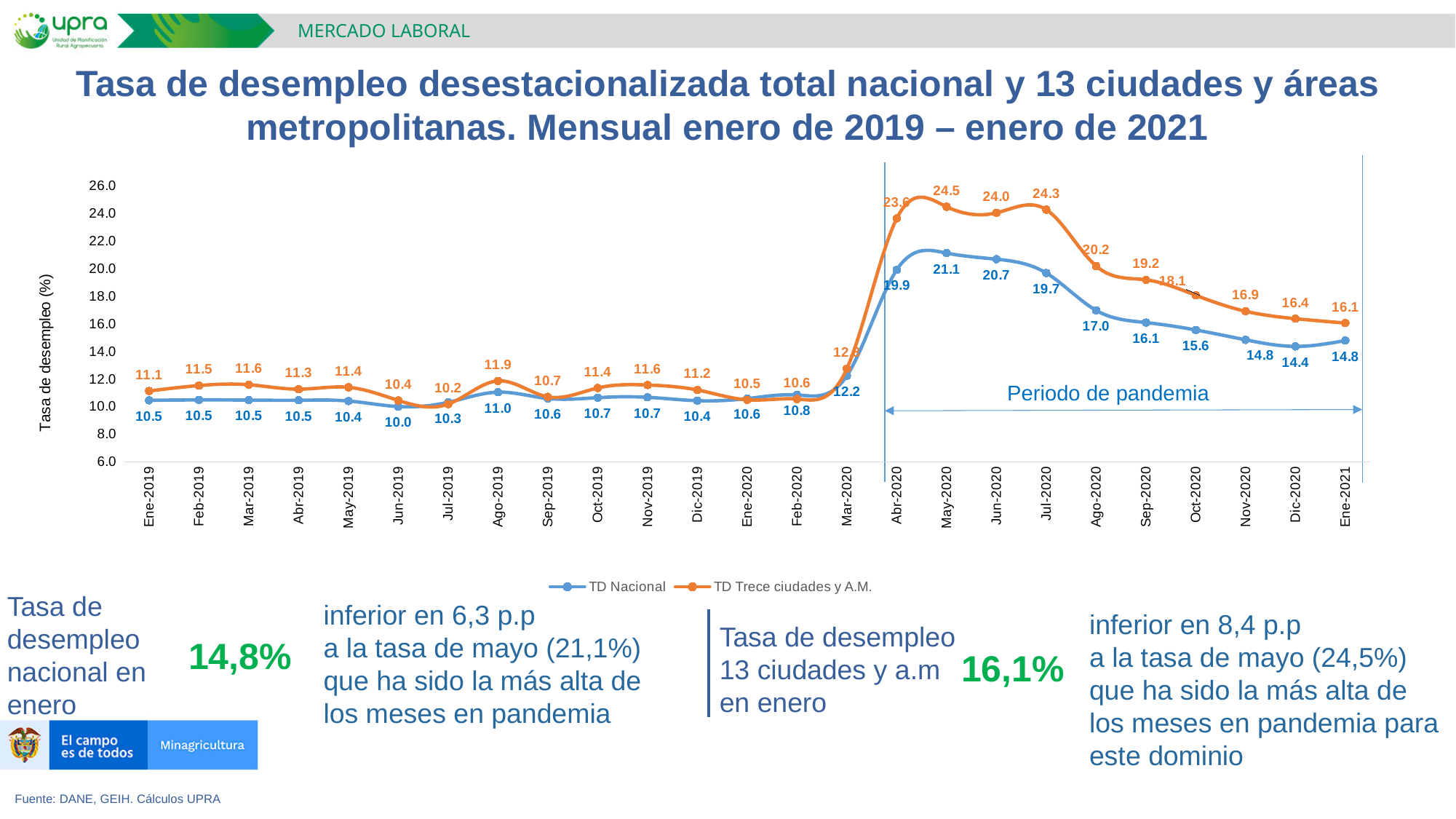
What kind of chart is shown on the slide? Line chart What is the TD Nacional value for Ene-2021? 14.8 Is the TD Nacional value for Ago-2020 greater or less than 16.0? greater Which series has the higher value in Abr-2020? TD Trece ciudades y A.M. What is the TD Trece ciudades y A.M. value for May-2020? 24.5 What is the difference between TD Trece ciudades y A.M. and TD Nacional in Ene-2021? 1.3 How many series does the legend list? 2 In which month does TD Nacional reach its highest value? May-2020 In which month does TD Nacional reach its lowest value? Jun-2019 Does TD Nacional rise or fall from May-2020 to Dic-2020? Fall By how much is the TD Nacional value in May-2020 higher than in Ene-2021? 6.3 How many months are plotted along the x axis? 25